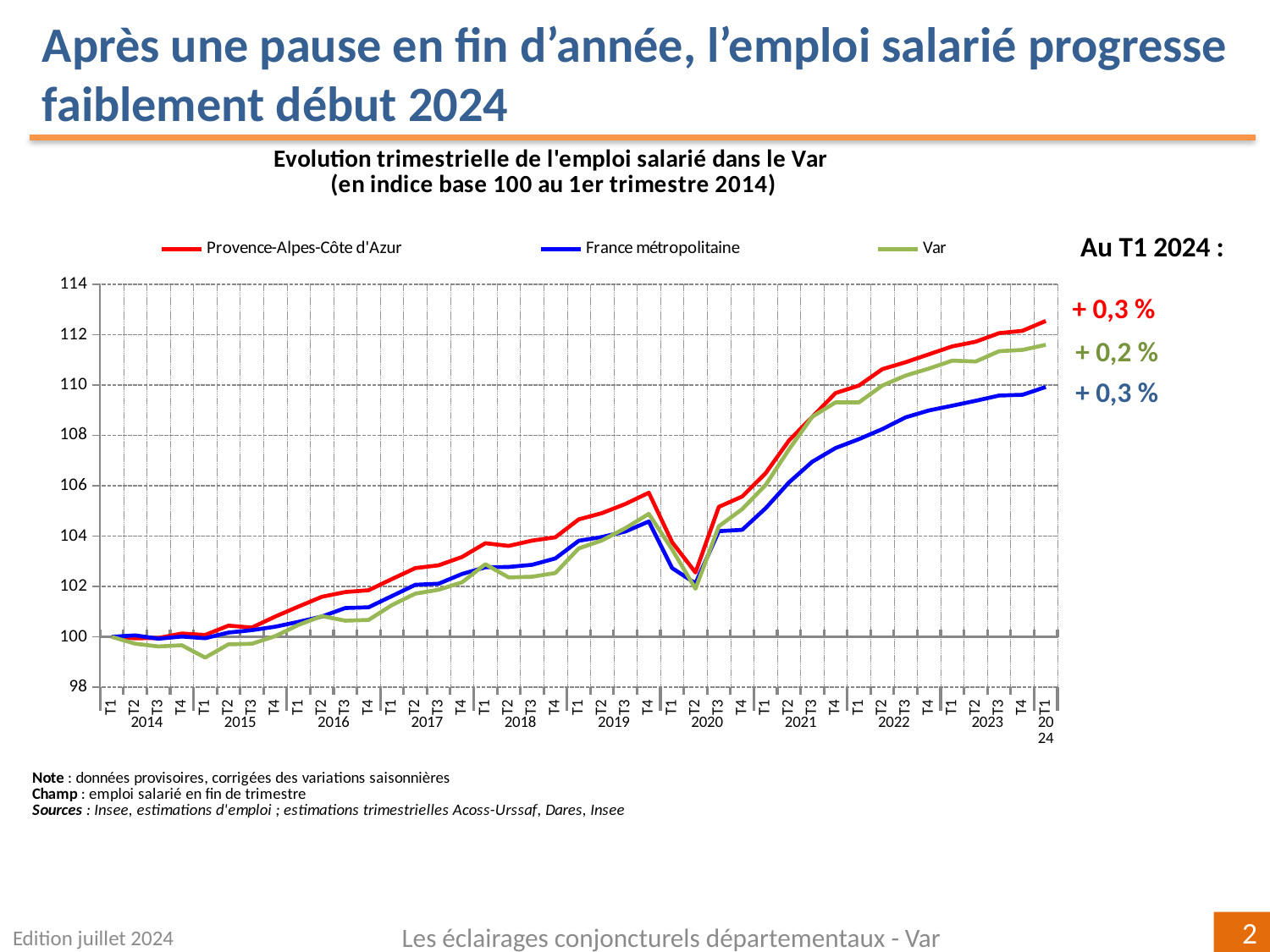
At T1 2024, which is higher: the Var line or the France métropolitaine line? Var Is the value for Var at T1 2015 greater or less than 100? less Is the value for Provence-Alpes-Côte d'Azur at T1 2024 greater or less than 112? greater Which series has the highest index value at T1 2024? Provence-Alpes-Côte d'Azur What kind of chart is shown on the slide? Line chart According to the annotation, what is the change for Var at T1 2024? + 0,2 % Overall, from T1 2014 to T1 2024, does the Var line rise or fall? Rise According to the annotation, what is the change for Provence-Alpes-Côte d'Azur at T1 2024? + 0,3 % Is the value for Var at T2 2020 greater or less than 104? less Which three series are listed in the chart legend? Provence-Alpes-Côte d'Azur, France métropolitaine, Var Which series has the lowest index value at T1 2024? France métropolitaine How many series does the legend of the chart list? 3